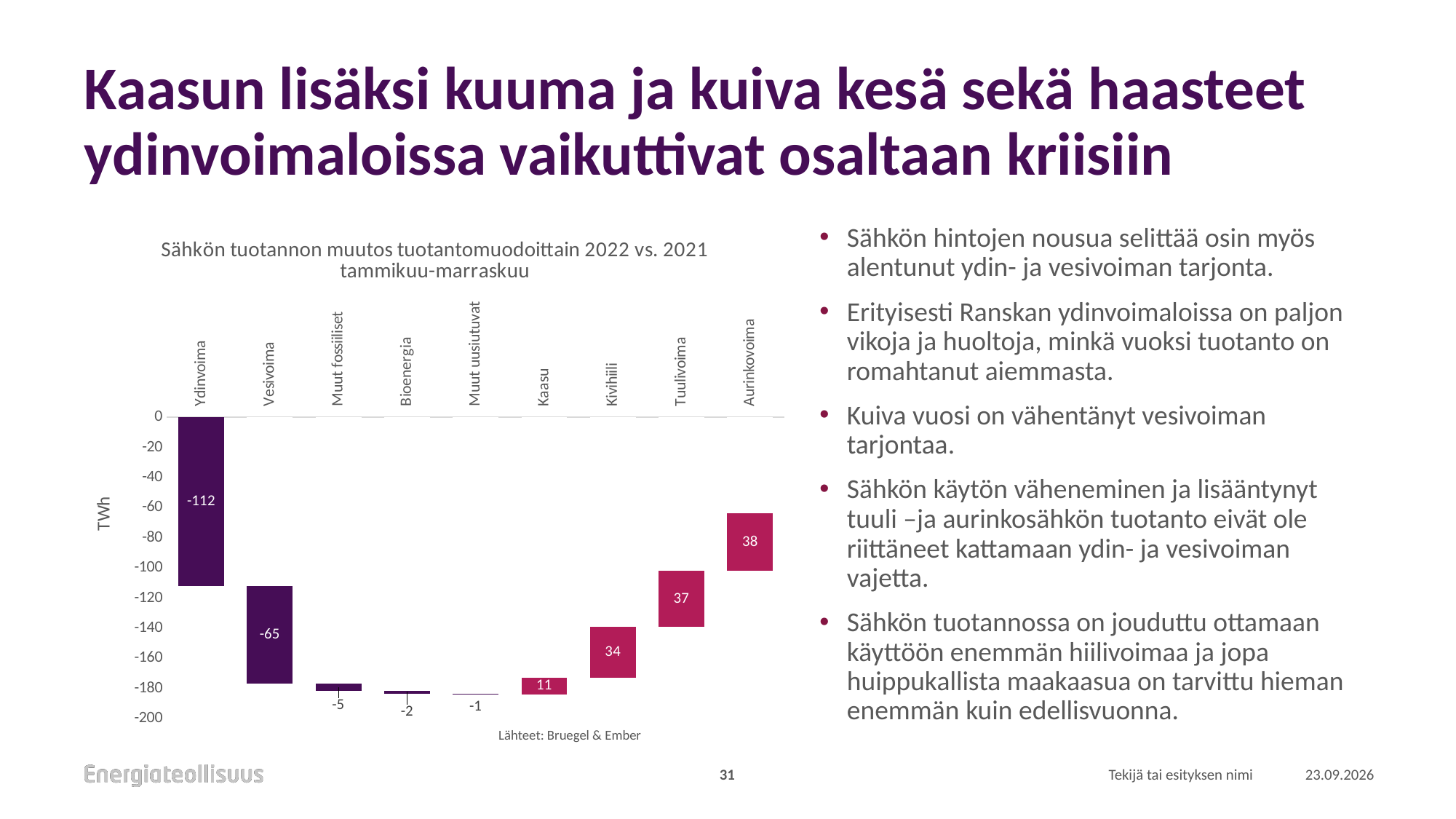
Which category has the highest value? Aurinkovoima What is the value for Tuulivoima? 37 What kind of chart is shown on the slide? bar chart What is the value for Bioenergia? -2 Which is larger, the value for Kivihiili or the value for Kaasu? Kivihiili Which category has the lowest value? Ydinvoima What is the difference between the values for Aurinkovoima and Tuulivoima? 1 What is the value for Ydinvoima? -112 What is the difference between the values for Ydinvoima and Vesivoima? 47 How many categories are shown in the chart? 9 What is the value for Kaasu? 11 What unit is shown on the vertical axis of the chart? TWh